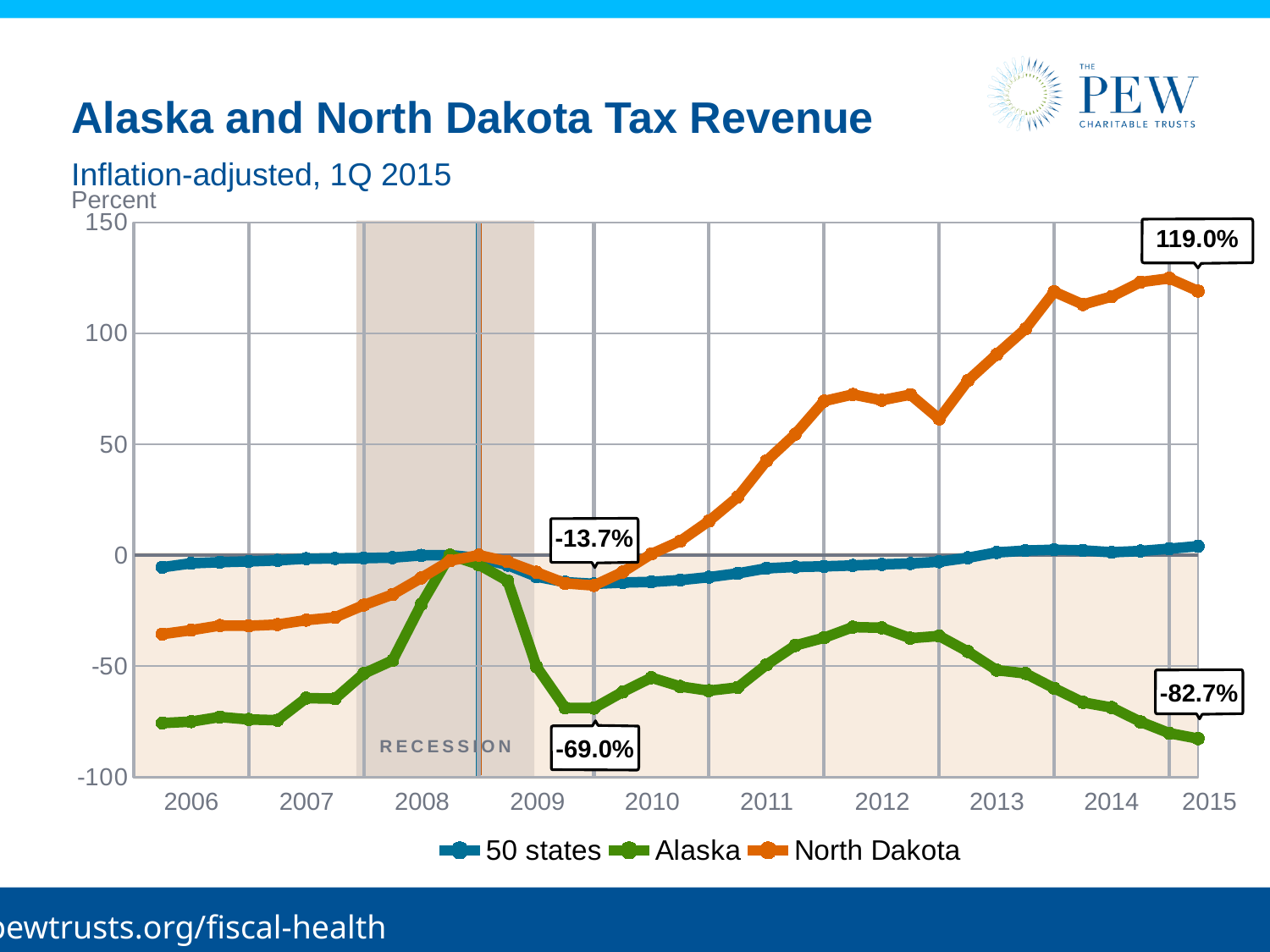
What is the labeled value for North Dakota at the end of the series in 2015? 119.0% What kind of chart is shown on the slide? Line chart What is the labeled value for Alaska at the end of the series in 2015? -82.7% Which series has the lowest value at the end of the chart in 2015? Alaska Which series has the highest value at the end of the chart in 2015? North Dakota How many series does the legend list? 3 Is the value for Alaska in 2006 greater or less than -50? less What is the labeled low value for Alaska around 2009? -69.0% Is the value for North Dakota in 2012 greater or less than 50? greater What is the difference between the labeled 2015 values for North Dakota (119.0%) and Alaska (-82.7%)? 201.7 percentage points Does the North Dakota series generally rise or fall from 2006 to 2015? Rise